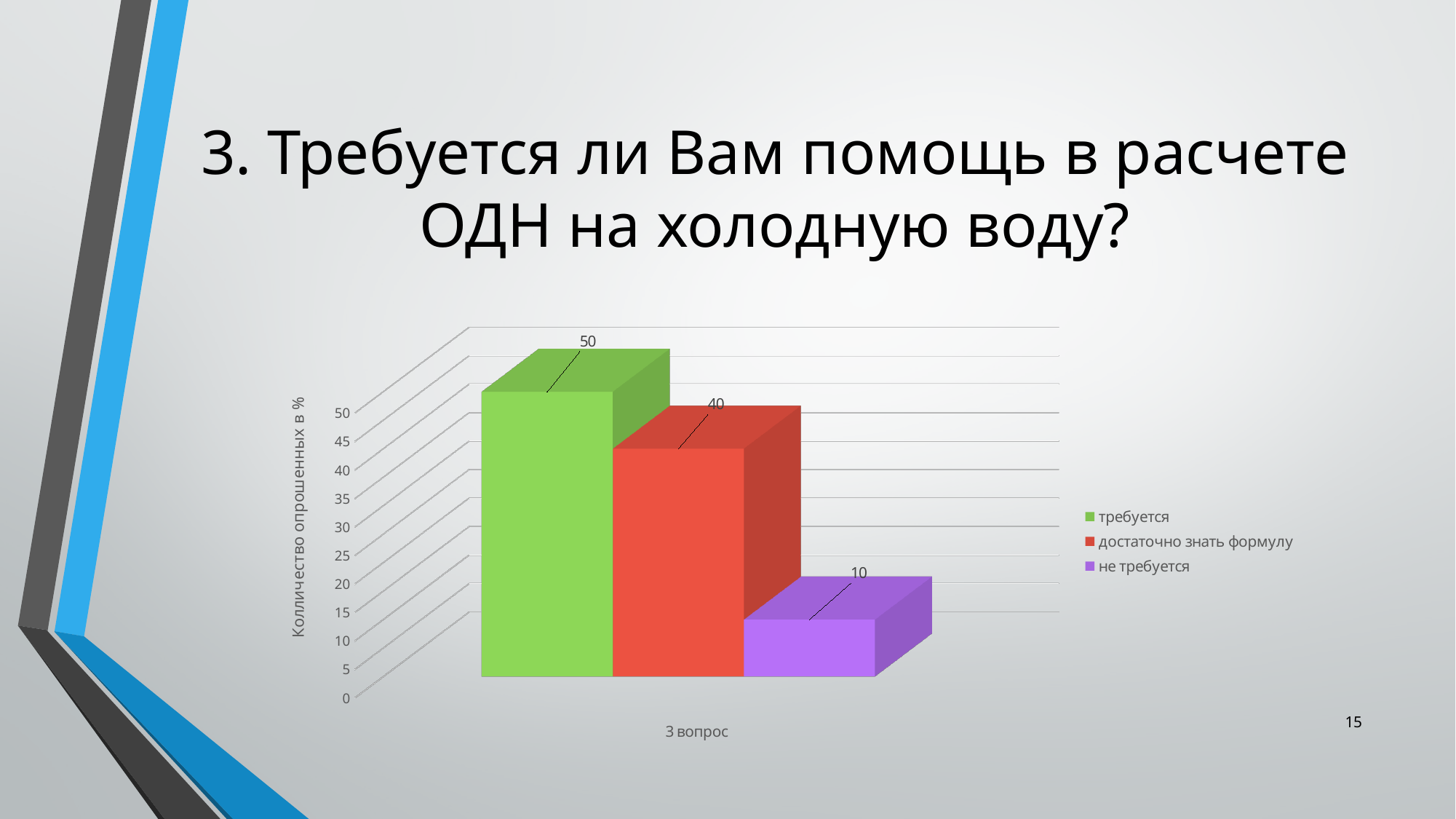
What kind of chart is shown on the slide? bar chart What is the difference between the values for "требуется" and "достаточно знать формулу"? 10 What is the category label on the horizontal axis? 3 вопрос Which is larger: the value for "достаточно знать формулу" or the value for "не требуется"? достаточно знать формулу What is the label of the vertical axis? Колличество опрошенных в % What is the value for "достаточно знать формулу"? 40 What is the value for "не требуется"? 10 What is the difference between the values for "достаточно знать формулу" and "не требуется"? 30 Which series has the lowest value? не требуется What is the value for "требуется"? 50 Which series has the highest value? требуется How many series does the legend list? 3